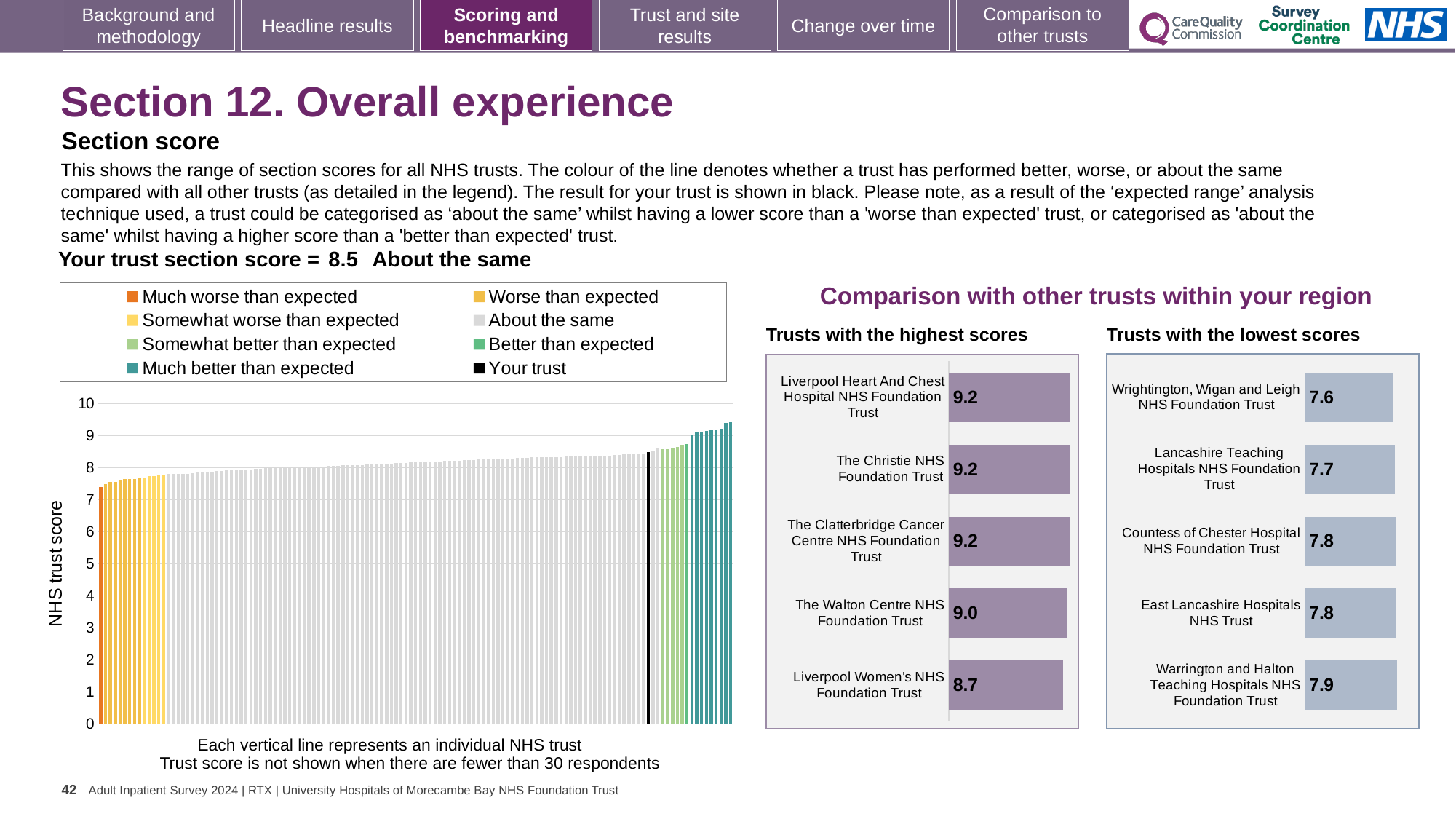
In the 'Trusts with the lowest scores' chart, which has the larger score: Lancashire Teaching Hospitals NHS Foundation Trust or Countess of Chester Hospital NHS Foundation Trust? Countess of Chester Hospital NHS Foundation Trust In the 'Trusts with the highest scores' chart, how many trusts are shown? 5 In the 'Trusts with the highest scores' chart, what is the score for The Walton Centre NHS Foundation Trust? 9.0 In the large chart on the left showing NHS trust scores, do the values rise or fall from left to right? Rise In the 'Trusts with the highest scores' chart, what is the difference between the scores of The Walton Centre NHS Foundation Trust and Liverpool Women's NHS Foundation Trust? 0.3 In the 'Trusts with the highest scores' chart, what is the score for Liverpool Women's NHS Foundation Trust? 8.7 In the 'Trusts with the lowest scores' chart, which trust has the highest score? Warrington and Halton Teaching Hospitals NHS Foundation Trust In the large chart on the left showing NHS trust scores, what kind of chart is it? Bar chart In the large chart on the left showing NHS trust scores, how many entries does the legend list? 8 In the 'Trusts with the lowest scores' chart, what is the score for Wrightington, Wigan and Leigh NHS Foundation Trust? 7.6 In the 'Trusts with the highest scores' chart, which trust has the lowest score? Liverpool Women's NHS Foundation Trust In the 'Trusts with the lowest scores' chart, what is the difference between the scores of Warrington and Halton Teaching Hospitals NHS Foundation Trust and Wrightington, Wigan and Leigh NHS Foundation Trust? 0.3